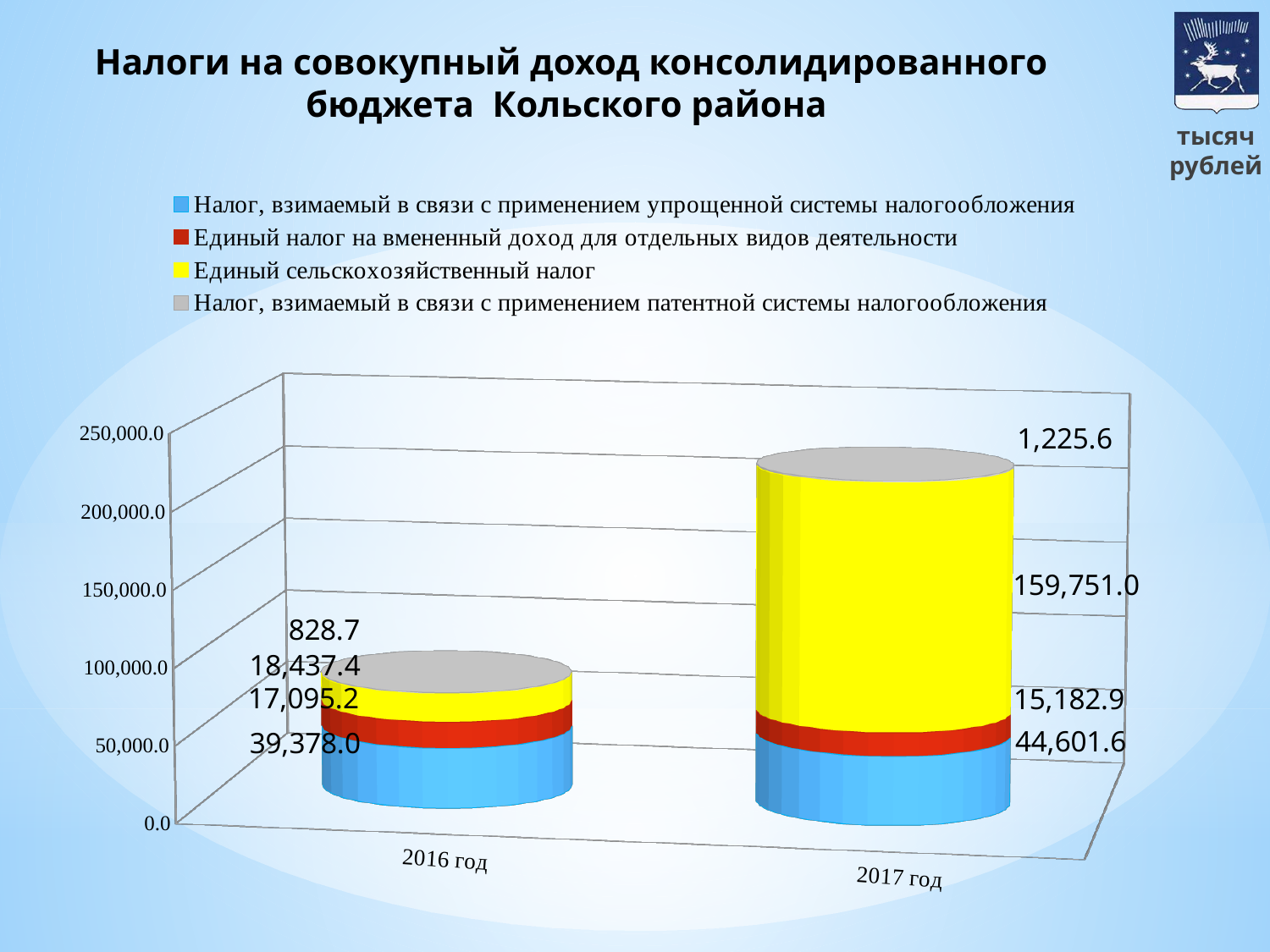
What is the total of the stacked bar for 2016 год? 75,739.3 What kind of chart is shown on the slide? Stacked bar chart What is the value of the patent system tax (Налог, взимаемый в связи с применением патентной системы налогообложения) for 2016 год? 828.7 What is the total of the stacked bar for 2017 год? 220,761.1 How many categories (years) are shown on the x axis? 2 Which colour represents the unified agricultural tax (Единый сельскохозяйственный налог) in the chart? Yellow What is the value of the unified agricultural tax (Единый сельскохозяйственный налог) for 2017 год? 159,751.0 What is the value of the simplified taxation system tax (Налог, взимаемый в связи с применением упрощенной системы налогообложения) for 2016 год? 39,378.0 What is the value of the unified tax on imputed income (Единый налог на вмененный доход) for 2017 год? 15,182.9 How many series does the legend list? 4 By how much did the unified agricultural tax (Единый сельскохозяйственный налог) increase from 2016 год to 2017 год? 141,313.6 Which year has the larger value for the unified tax on imputed income (Единый налог на вмененный доход): 2016 год or 2017 год? 2016 год